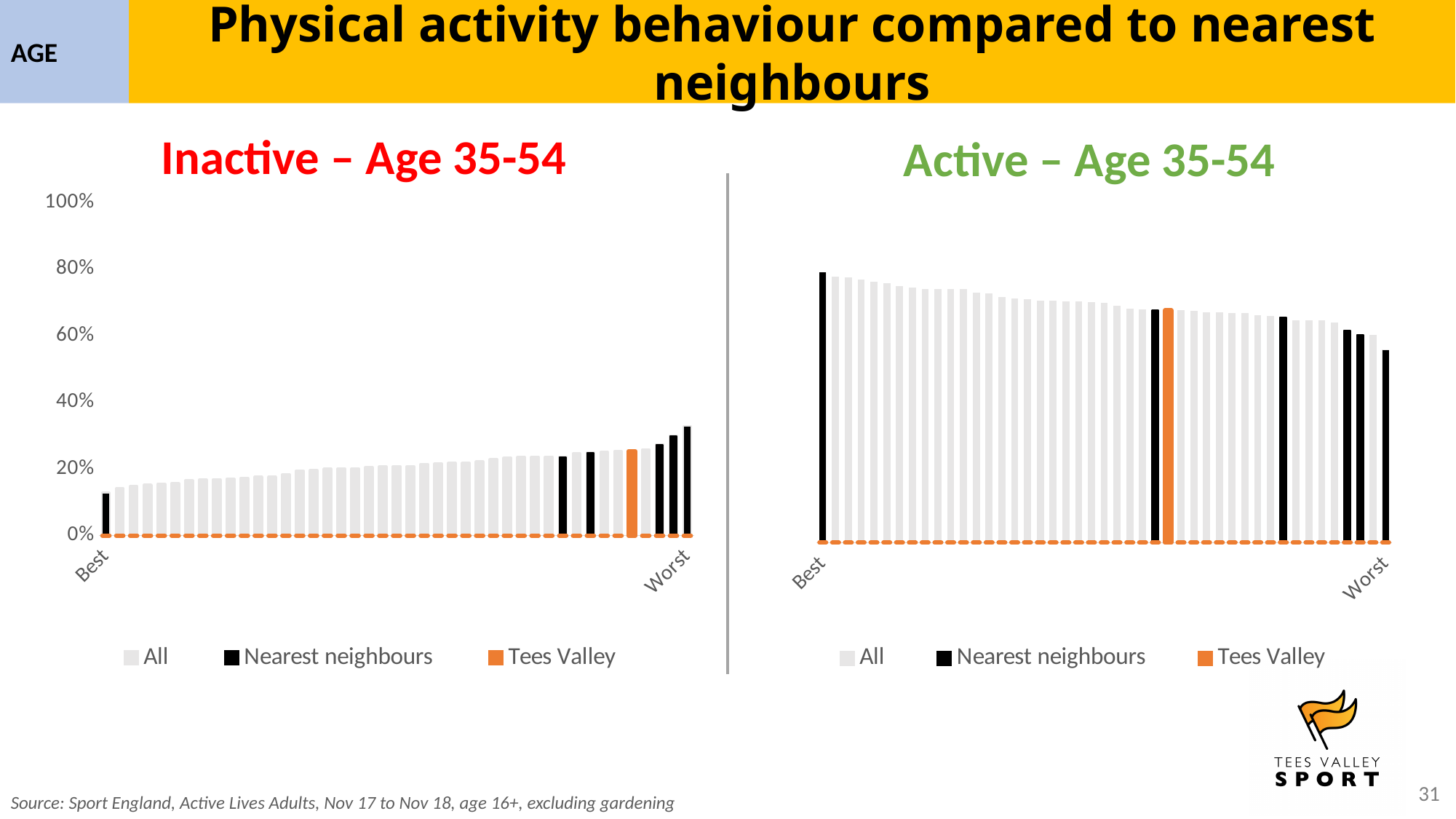
Which colour represents Tees Valley in the legend of the Inactive – Age 35-54 chart? orange In the Active – Age 35-54 chart, is the value for Tees Valley greater or less than 80%? less What are the two labels shown on the x axis of the Active – Age 35-54 chart? Best and Worst How many series does the legend of the Active – Age 35-54 chart list? 3 In the Inactive – Age 35-54 chart, is the value for Tees Valley greater or less than 20%? greater In the Active – Age 35-54 chart, is the value for Tees Valley greater or less than 60%? greater In the Inactive – Age 35-54 chart, do the bars rise or fall from Best to Worst along the x axis? rise In the Active – Age 35-54 chart, do the bars rise or fall from Best to Worst along the x axis? fall What kind of chart is the Inactive – Age 35-54 chart? bar chart